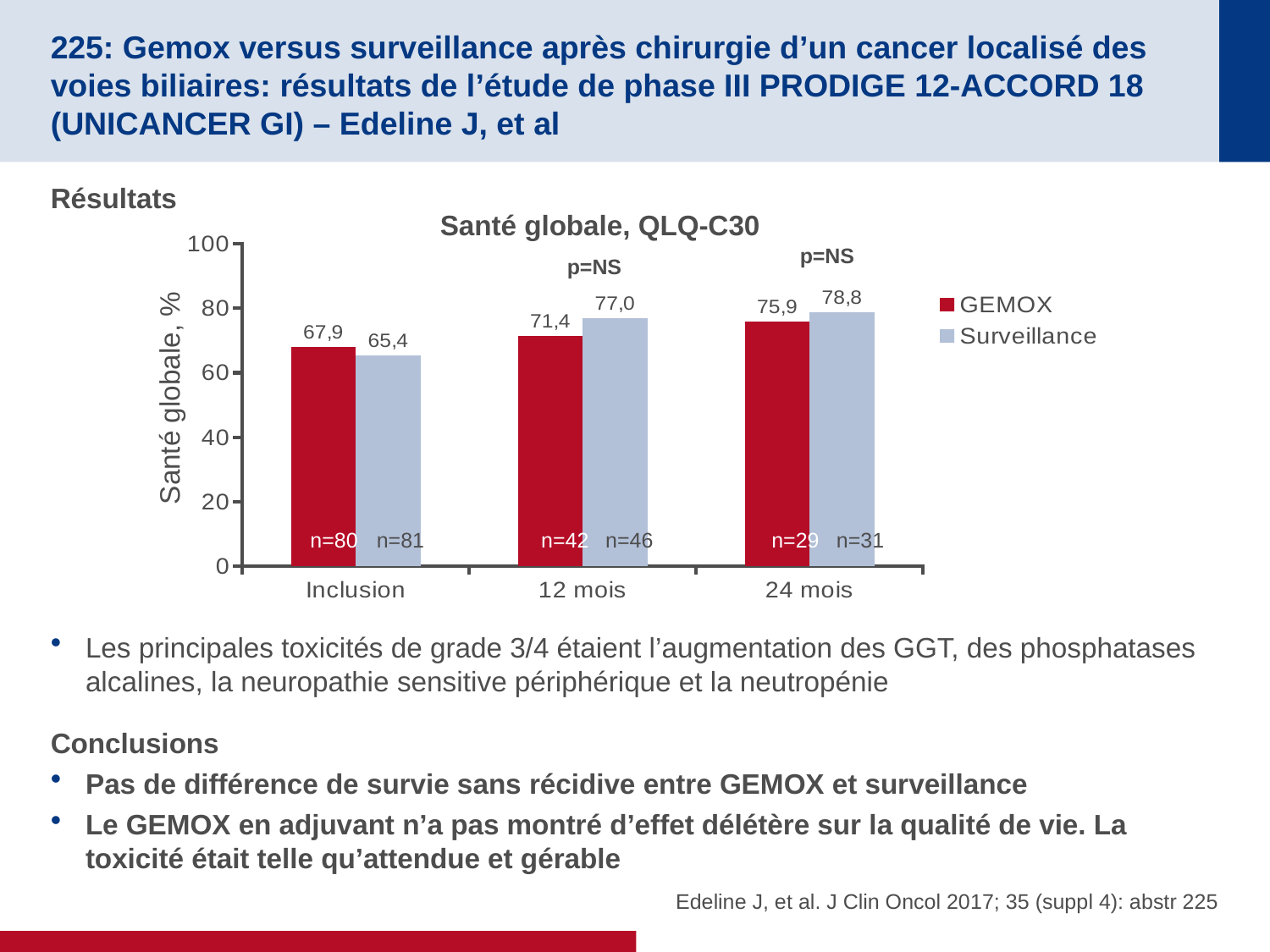
Which time point has the highest GEMOX value? 24 mois What is the difference between the Surveillance and GEMOX values at 12 mois? 5,6 How many time points are shown on the x axis? 3 What is the title of the chart? Santé globale, QLQ-C30 Which time point has the lowest Surveillance value? Inclusion At Inclusion, which series has the larger value, GEMOX or Surveillance? GEMOX Do the Surveillance values rise or fall from Inclusion to 24 mois? Rise How many series does the legend list? 2 What is the Surveillance value at 24 mois? 78,8 What kind of chart is shown? Bar chart What is the Surveillance value at 12 mois? 77,0 What is the GEMOX value at Inclusion? 67,9